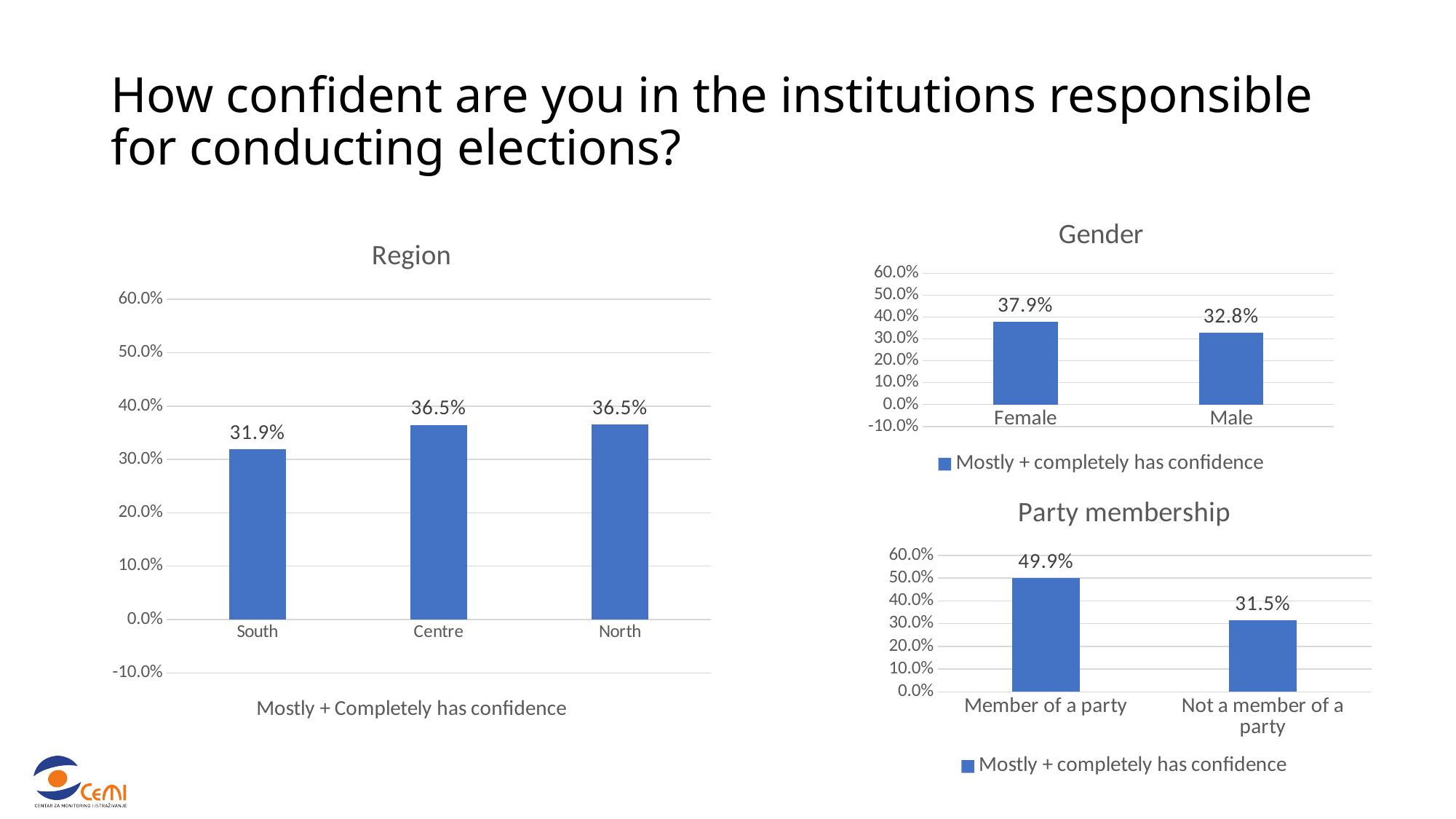
In the Region chart, how many regions are shown? 3 What kind of chart is the Gender chart? Bar chart In the Gender chart, what is the value for Female? 37.9% In the Party membership chart, what is the difference between Member of a party and Not a member of a party? 18.4% In the Gender chart, which is larger, Female or Male? Female In the Region chart, which region has the lowest value? South In the Region chart, what is the value for Centre? 36.5% In the Region chart, what is the difference between Centre and South? 4.6% In the Party membership chart, what is the value for Not a member of a party? 31.5% In the Party membership chart, what is the value for Member of a party? 49.9% In the Gender chart, what is the difference between Female and Male? 5.1% In the Region chart, what is the value for South? 31.9%